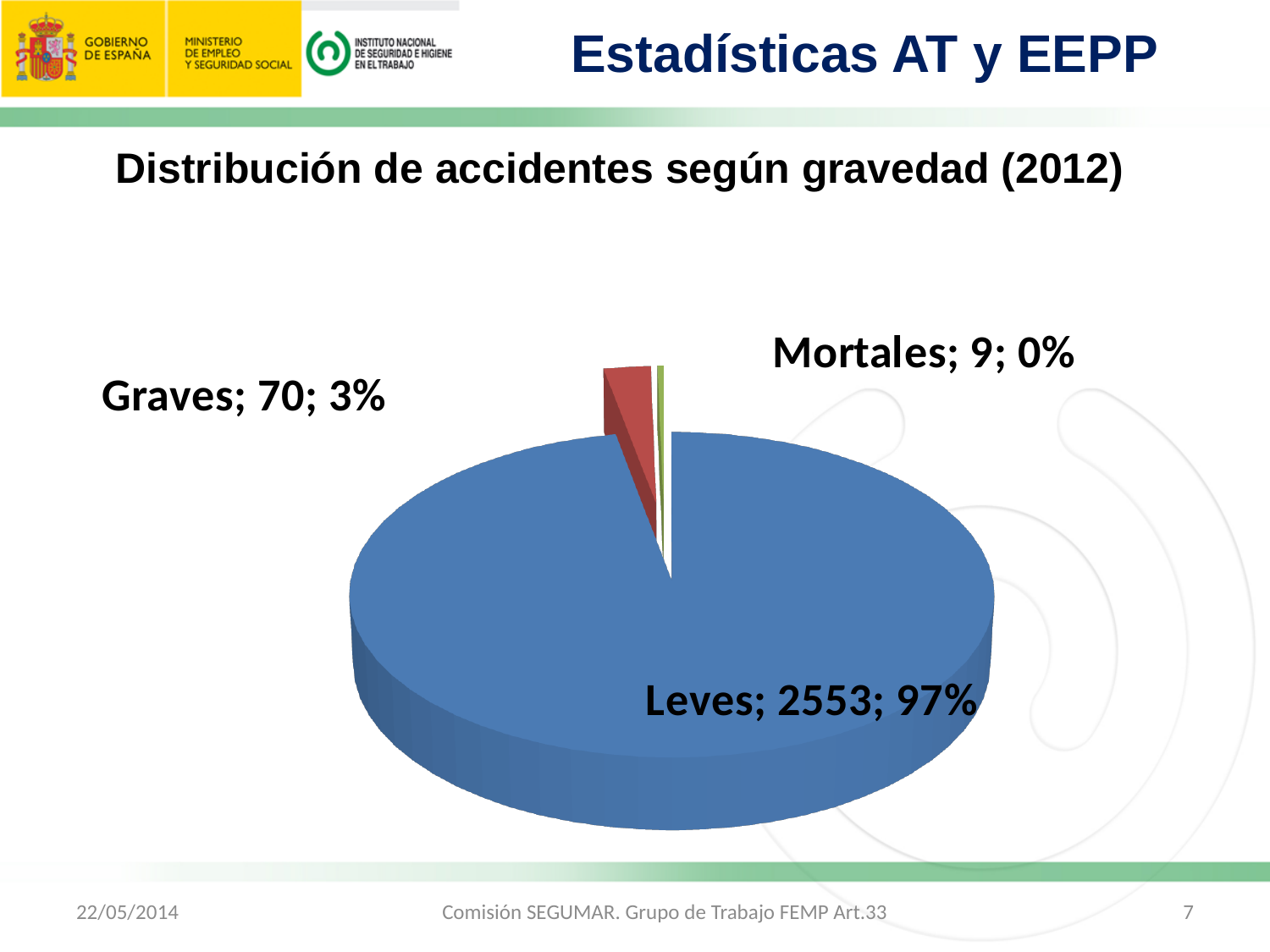
How many categories does the pie chart show? 3 What share of the pie does the Graves slice represent? 3% What kind of chart is shown on the slide? Pie chart Which category has the lowest number of accidents? Mortales What share of the pie does the Mortales slice represent? 0% How many accidents are in the Graves category? 70 How many accidents are in the Leves category? 2553 Which category has the highest number of accidents? Leves What share of the pie does the Leves slice represent? 97% What is the difference between the number of Graves and Mortales accidents? 61 How many accidents are in the Mortales category? 9 Which has more accidents, Graves or Mortales? Graves